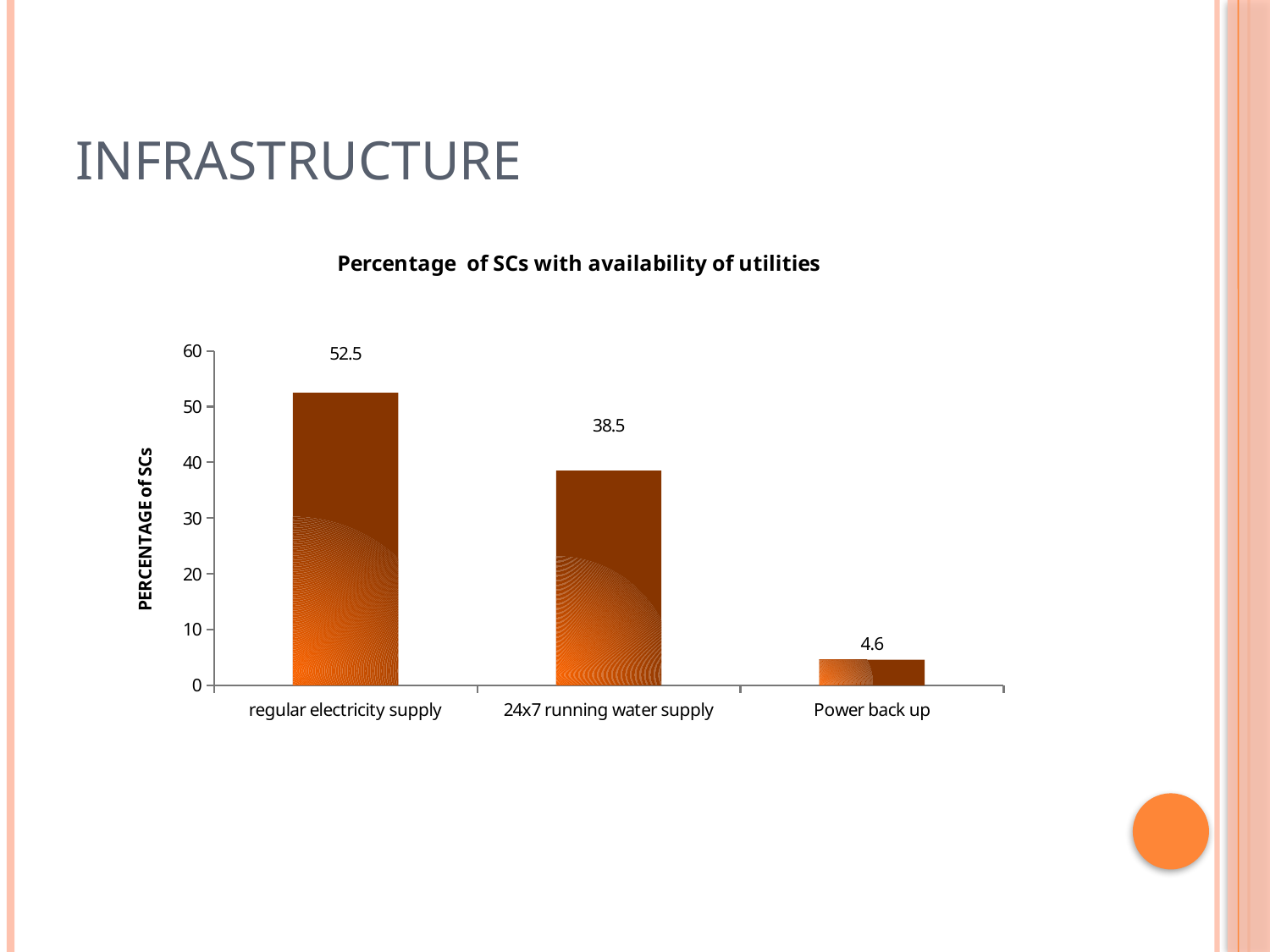
What is the difference between the values for 24x7 running water supply and Power back up? 33.9 Which category has the lowest value? Power back up What is the value for regular electricity supply? 52.5 What is the title of the chart? Percentage of SCs with availability of utilities Which is larger, the value for 24x7 running water supply or the value for Power back up? 24x7 running water supply Which category has the highest value? regular electricity supply Is the value for regular electricity supply greater or less than 50? greater What is the value for 24x7 running water supply? 38.5 What is the difference between the values for regular electricity supply and 24x7 running water supply? 14 How many categories are shown on the x axis? 3 What is the value for Power back up? 4.6 What kind of chart is shown on the slide? bar chart